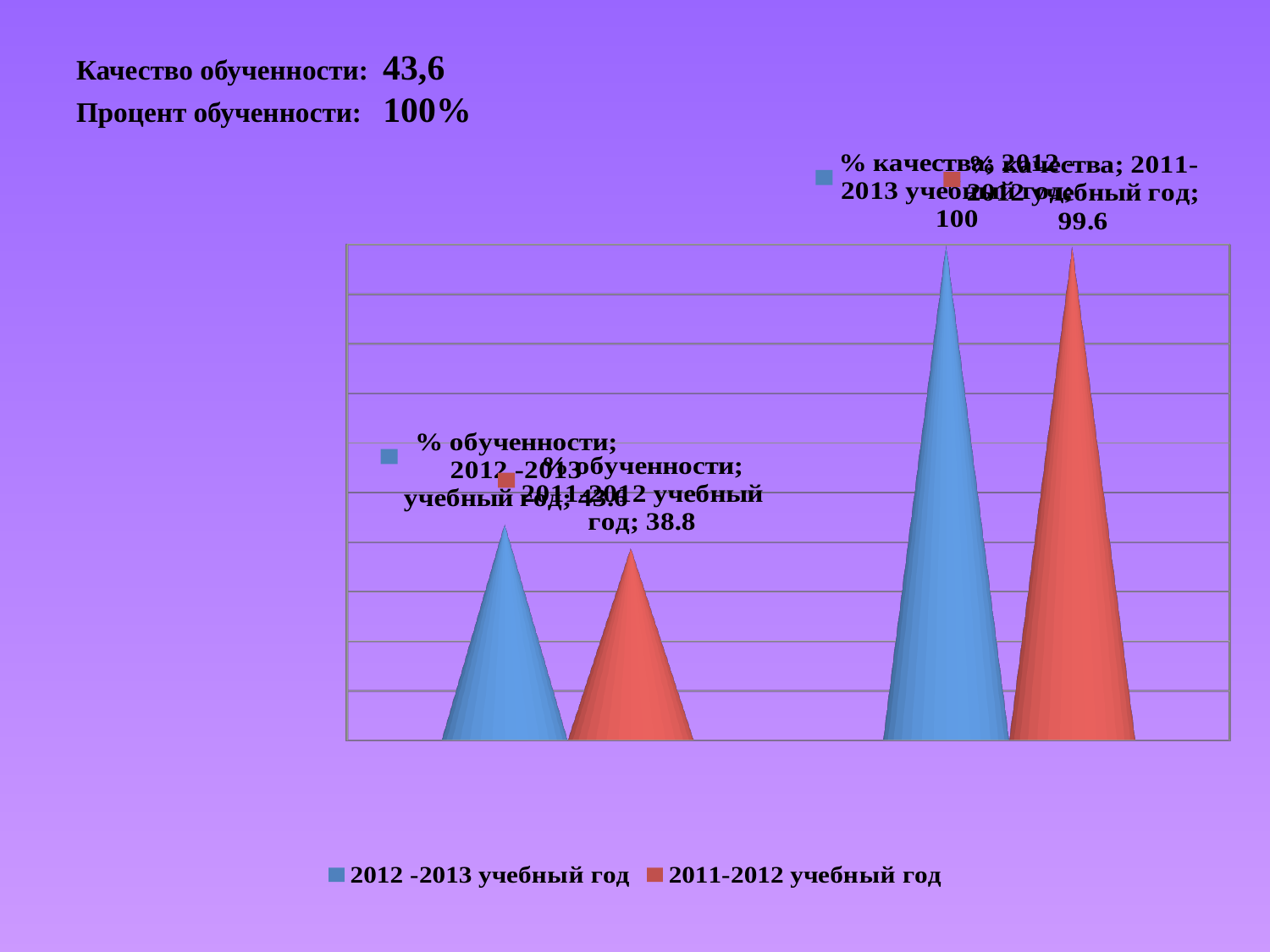
What is the difference between the 2012 -2013 and 2011-2012 values for % обученности? 4.8 What is the value for 2011-2012 учебный год in the % качества category? 99.6 What is the difference between the 2012 -2013 and 2011-2012 values for % качества? 0.4 What is the value for 2011-2012 учебный год in the % обученности category? 38.8 What is the value for 2012 -2013 учебный год in the % обученности category? 43.6 Which category has the lowest value for the 2011-2012 учебный год series? % обученности How many series does the legend list? 2 What is the value for 2012 -2013 учебный год in the % качества category? 100 Which category has the highest value for the 2012 -2013 учебный год series? % качества How many categories are shown on the chart? 2 Which series has the higher value in the % обученности category? 2012 -2013 учебный год Which colour represents the 2011-2012 учебный год series? Red